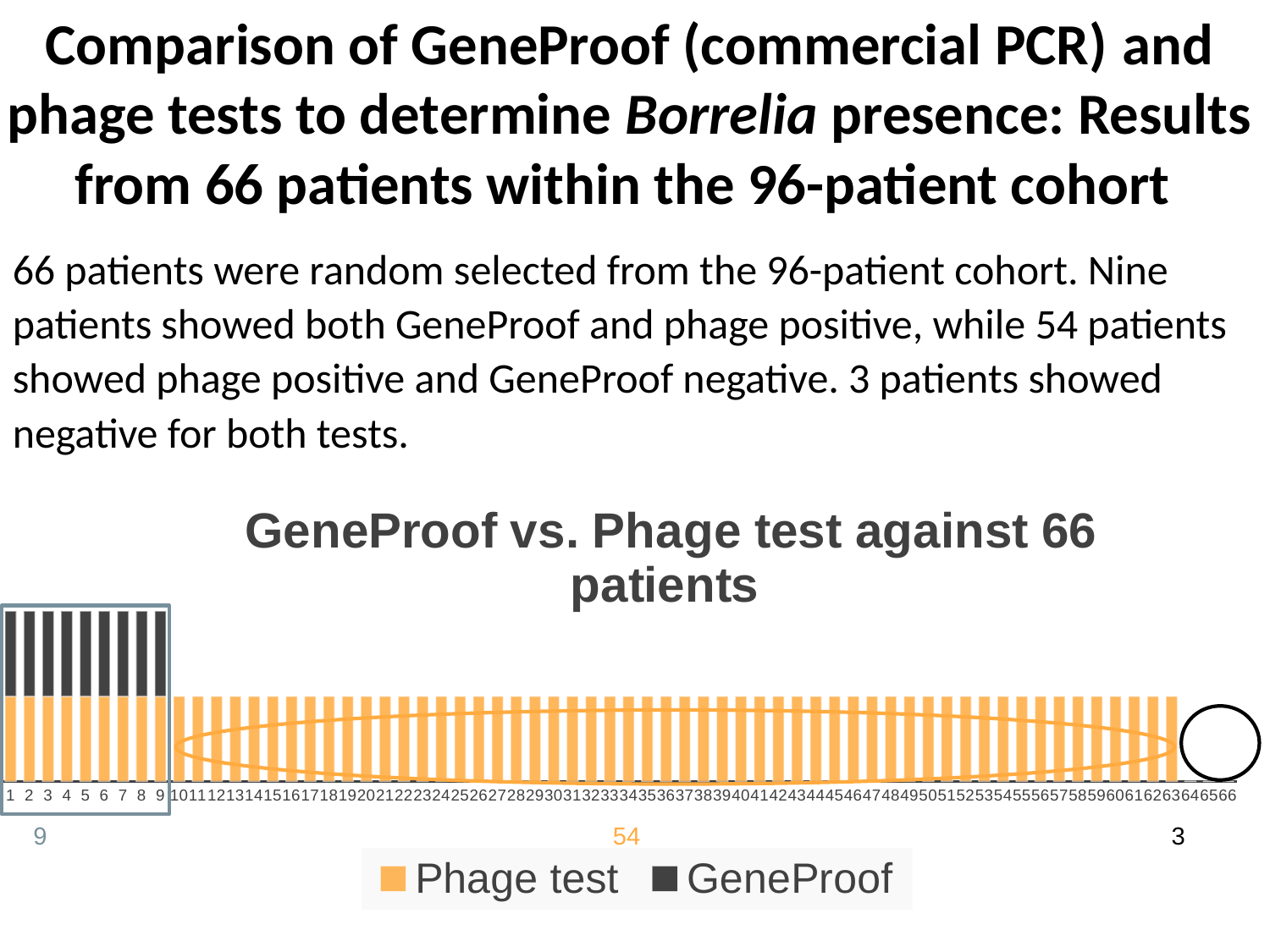
Do the bars for patients 64, 65 and 66 show any Phage test or GeneProof segment? No Which is taller in the chart: the stacked bar for patient 5 or the bar for patient 20? Patient 5 What kind of chart is shown on the slide? Bar chart How many series does the chart legend list? 2 How many patient categories are plotted along the x axis of the chart? 66 Which series in the chart is shown in orange? Phage test According to the number annotated under the circled group of orange bars, how many patients were phage positive and GeneProof negative? 54 According to the number annotated under the boxed group of bars on the left, how many patients were positive for both GeneProof and phage tests? 9 According to the number annotated at the right end of the chart, how many patients were negative for both tests? 3 What are the two series named in the chart legend? Phage test and GeneProof Which patients (by x-axis number) have a GeneProof segment in their bar? Patients 1 to 9 What is the title of the chart? GeneProof vs. Phage test against 66 patients